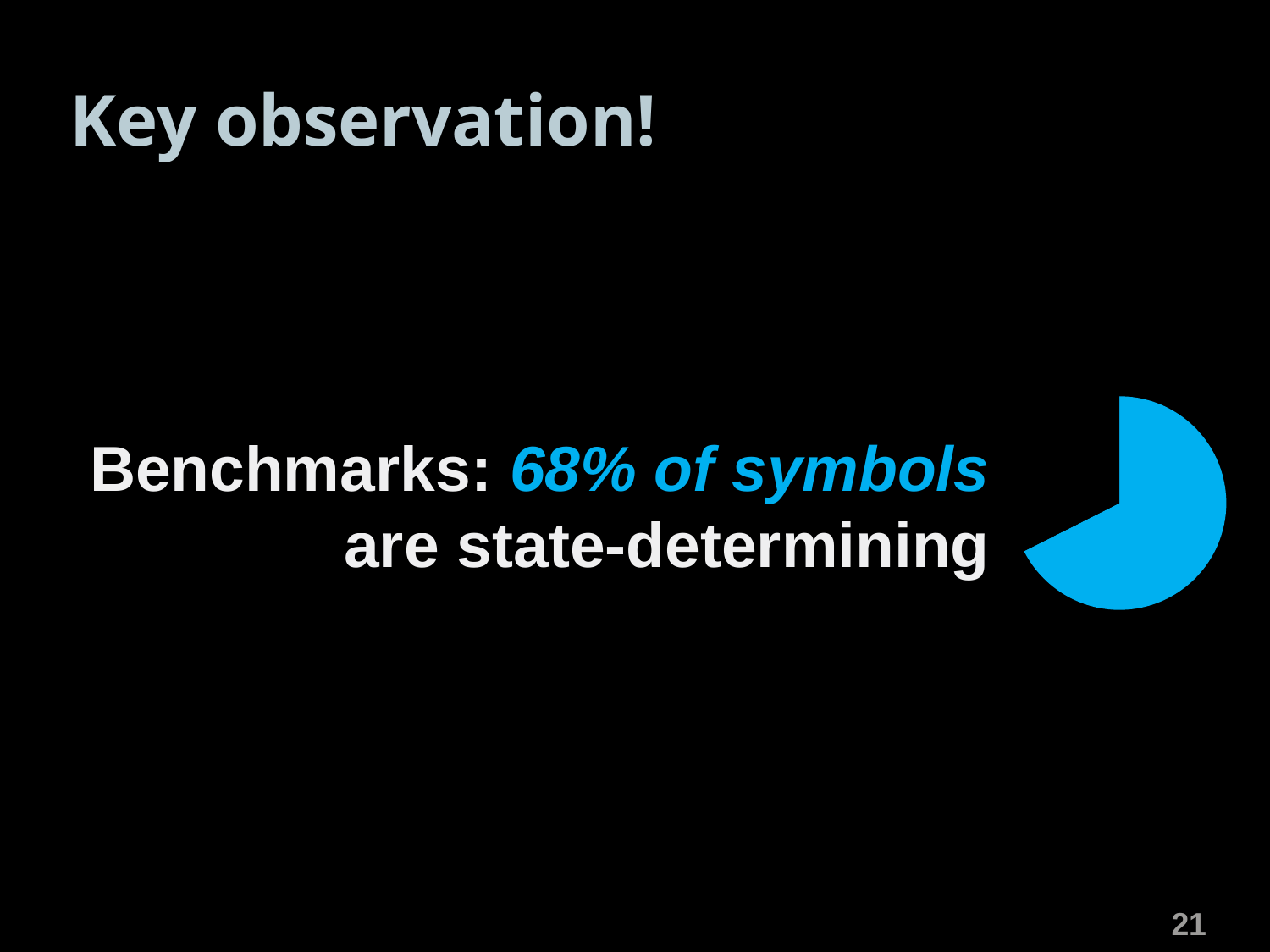
What kind of chart is shown on the slide? pie chart According to the slide, what share of symbols in the benchmarks are state-determining, as represented by the blue slice of the pie chart? 68% What colour is the highlighted slice of the pie chart? blue What is the title of the slide containing the pie chart? Key observation! Is the blue slice of the pie chart greater or less than 50% of the pie? greater